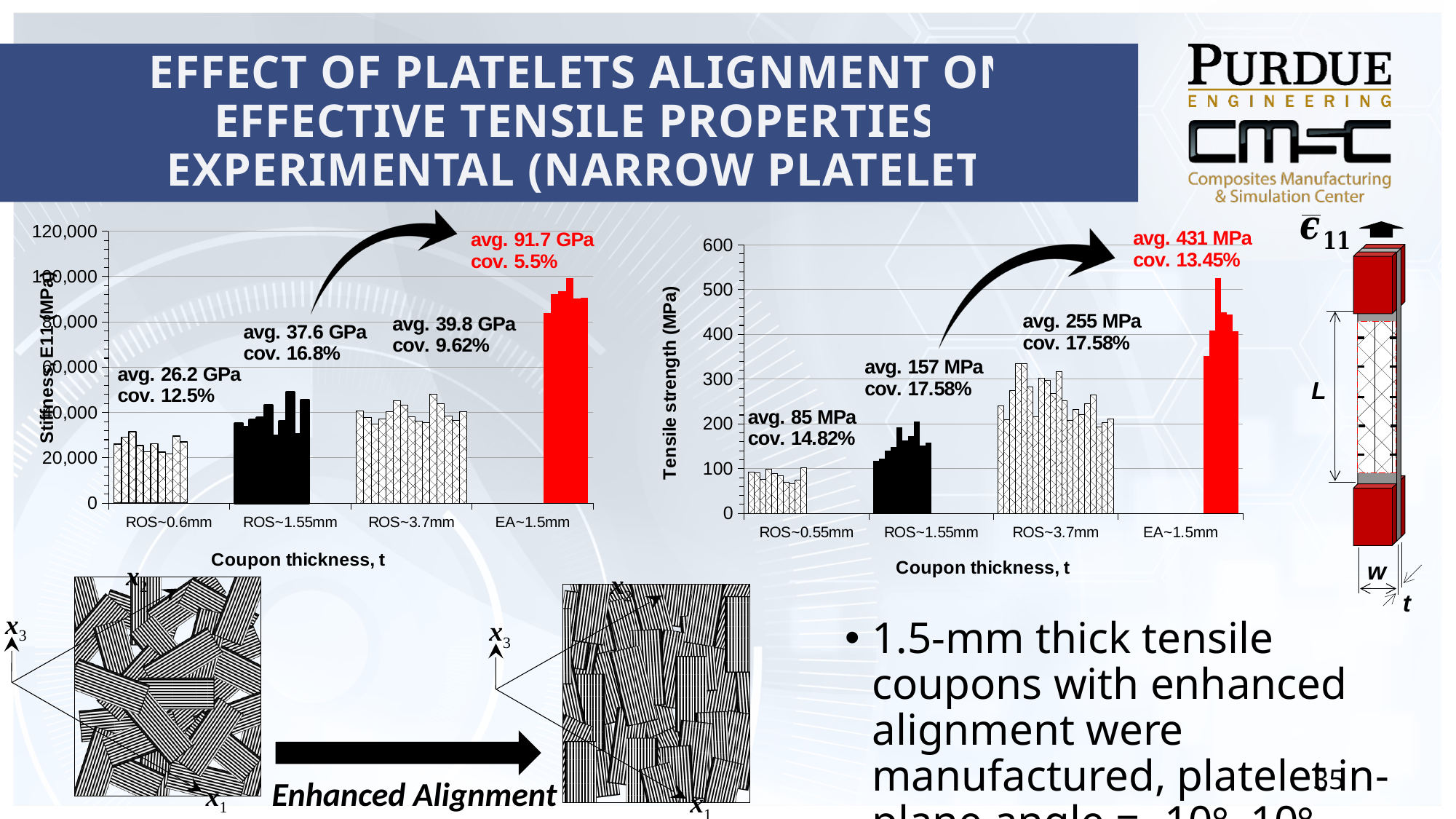
In the right chart (Tensile strength), what coefficient of variation is annotated for the EA~1.5mm group? 13.45% What kind of chart is the right chart (Tensile strength)? bar chart In the right chart (Tensile strength), what is the average tensile strength annotated for the ROS~3.7mm group? 255 MPa In the right chart (Tensile strength), what is the difference between the annotated average tensile strength of EA~1.5mm and ROS~3.7mm? 176 MPa In the right chart (Tensile strength), which coupon group has the highest annotated average tensile strength? EA~1.5mm In the left chart (Stiffness E11), what is the average stiffness annotated for the EA~1.5mm group? 91.7 GPa How many coupon thickness groups are shown on the x axis of the left chart (Stiffness E11)? 4 In the left chart (Stiffness E11), what coefficient of variation is annotated for the ROS~1.55mm group? 16.8% In the left chart (Stiffness E11), which coupon group has the lowest annotated average stiffness? ROS~0.6mm In the left chart (Stiffness E11), which has the larger annotated average stiffness, ROS~1.55mm or ROS~3.7mm? ROS~3.7mm What is the x-axis title of the right chart (Tensile strength)? Coupon thickness, t In the right chart (Tensile strength), are the bars for the ROS~0.55mm group greater or less than 200 MPa? less